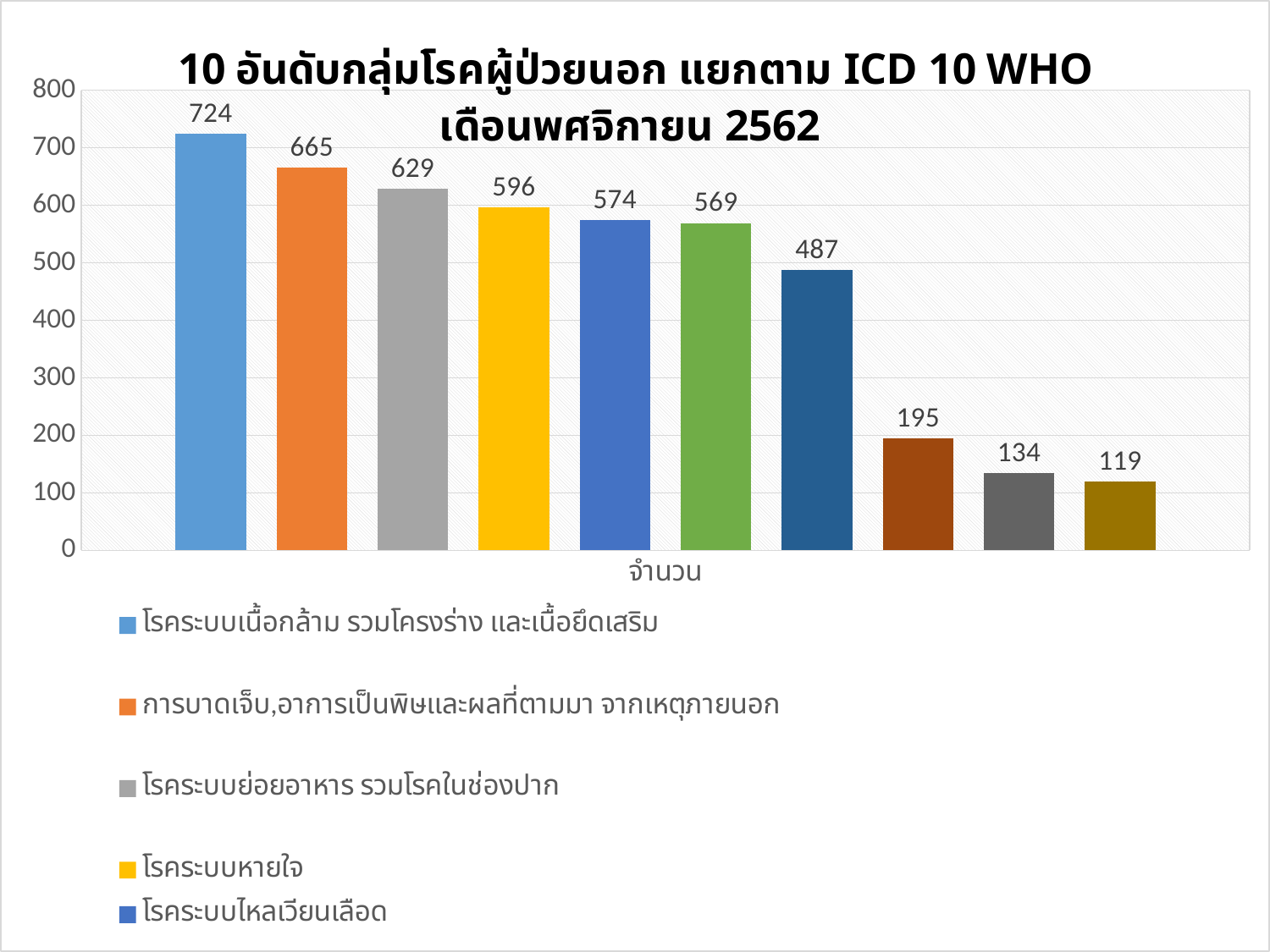
Which is larger, the value for โรคระบบย่อยอาหาร รวมโรคในช่องปาก or the value for โรคระบบไหลเวียนเลือด? โรคระบบย่อยอาหาร รวมโรคในช่องปาก Do the bar values rise or fall from left to right across the chart? fall What is the value for โรคระบบเนื้อกล้าม รวมโครงร่าง และเนื้อยึดเสริม? 724 What is the value of the lowest bar in the chart? 119 Which category has the highest value in the chart? โรคระบบเนื้อกล้าม รวมโครงร่าง และเนื้อยึดเสริม What is the value for โรคระบบหายใจ? 596 What is the value for โรคระบบย่อยอาหาร รวมโรคในช่องปาก? 629 What type of chart is shown on the slide? bar chart What is the value for โรคระบบไหลเวียนเลือด? 574 What is the value for การบาดเจ็บ,อาการเป็นพิษและผลที่ตามมา จากเหตุภายนอก? 665 How many bars are plotted in the chart? 10 What is the difference between the values for โรคระบบเนื้อกล้าม รวมโครงร่าง และเนื้อยึดเสริม and โรคระบบหายใจ? 128